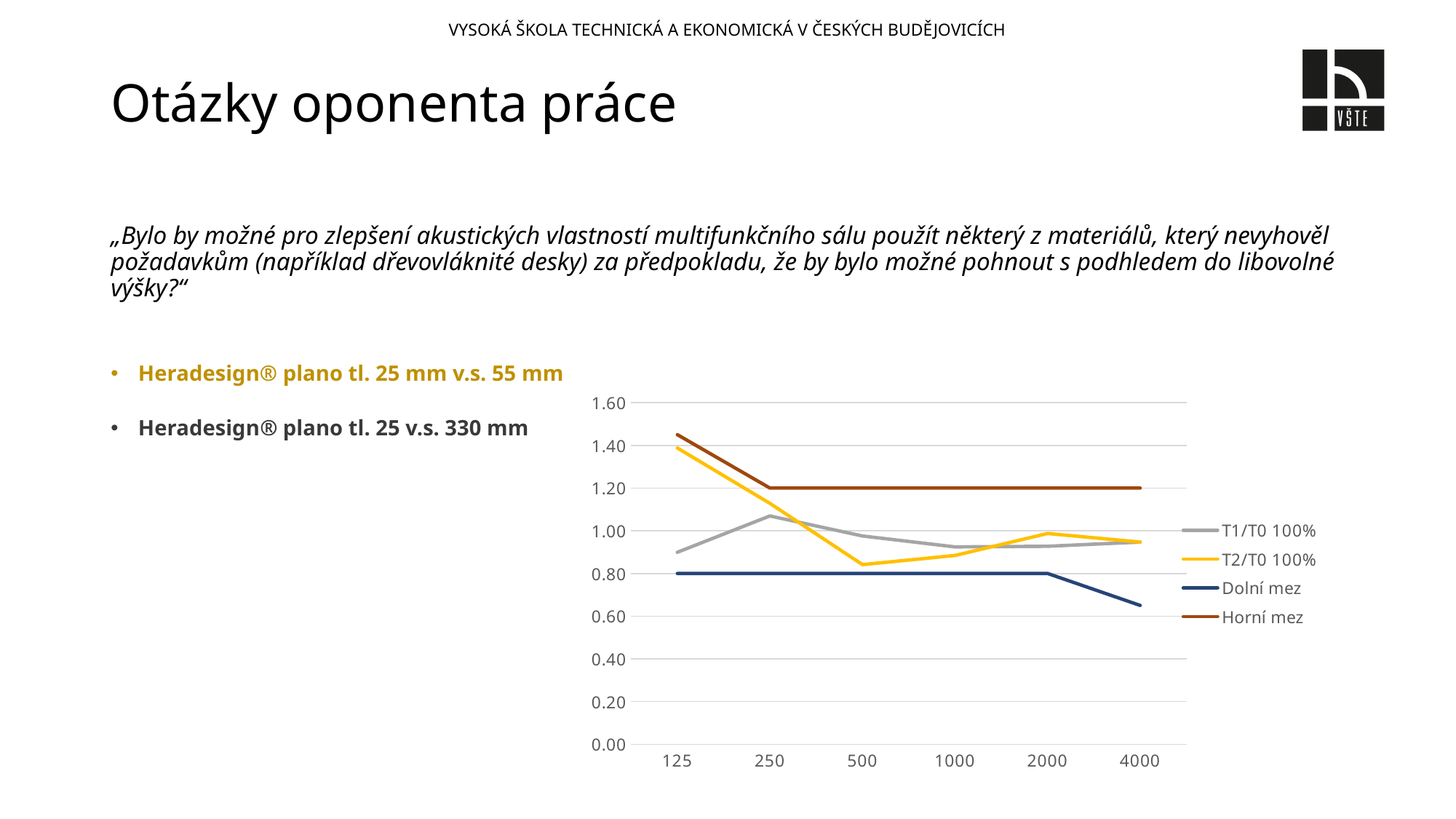
What is the value of Horní mez at 1000? 1.20 How many points are on the x axis of the chart? 6 What kind of chart is shown on the slide? line chart Which series is drawn in yellow in the chart? T2/T0 100% What is the value of Dolní mez at 125? 0.80 Is the value for Dolní mez at 4000 greater or less than 0.80? less Is the value for T2/T0 100% at 500 greater or less than 1.00? less How many series does the chart legend list? 4 Is the value for T2/T0 100% at 125 greater or less than 1.20? greater At which x-axis point does T2/T0 100% reach its lowest value? 500 At which x-axis point does T2/T0 100% reach its highest value? 125 At 500, which series has the larger value, T1/T0 100% or T2/T0 100%? T1/T0 100%